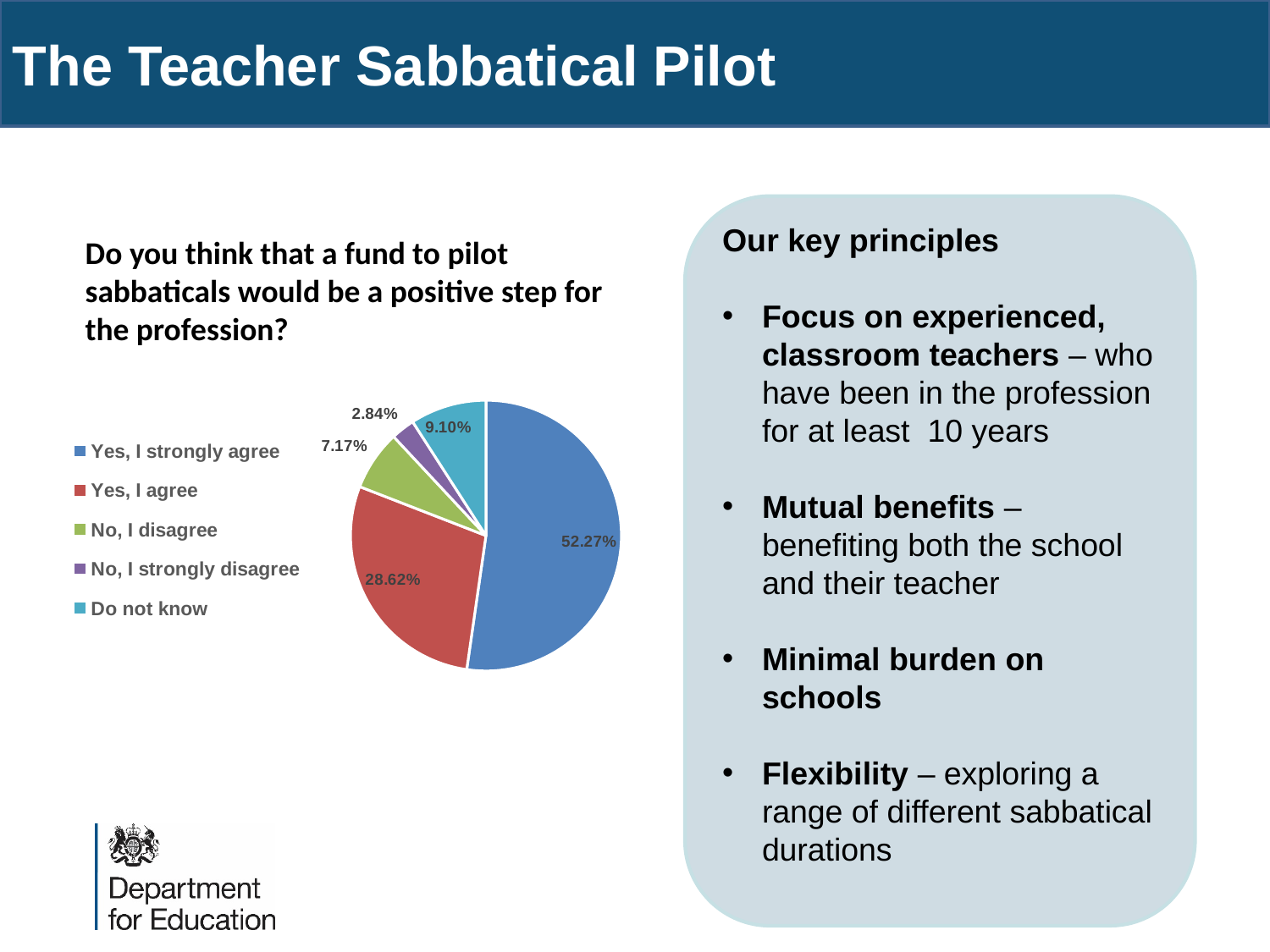
Which is larger: the share for "Do not know" or the share for "No, I disagree"? Do not know Which response has the smallest share of the pie? No, I strongly disagree What percentage of respondents answered "No, I disagree"? 7.17% How many response categories does the pie chart show? 5 What percentage of respondents answered "No, I strongly disagree"? 2.84% What percentage of respondents answered "Do not know"? 9.10% Which response has the largest share of the pie? Yes, I strongly agree What percentage of respondents answered "Yes, I agree"? 28.62% What percentage of respondents answered "Yes, I strongly agree"? 52.27% What colour is the slice for "Yes, I agree"? red What kind of chart is shown on the slide? pie chart What is the difference in percentage points between "Yes, I strongly agree" and "Yes, I agree"? 23.65